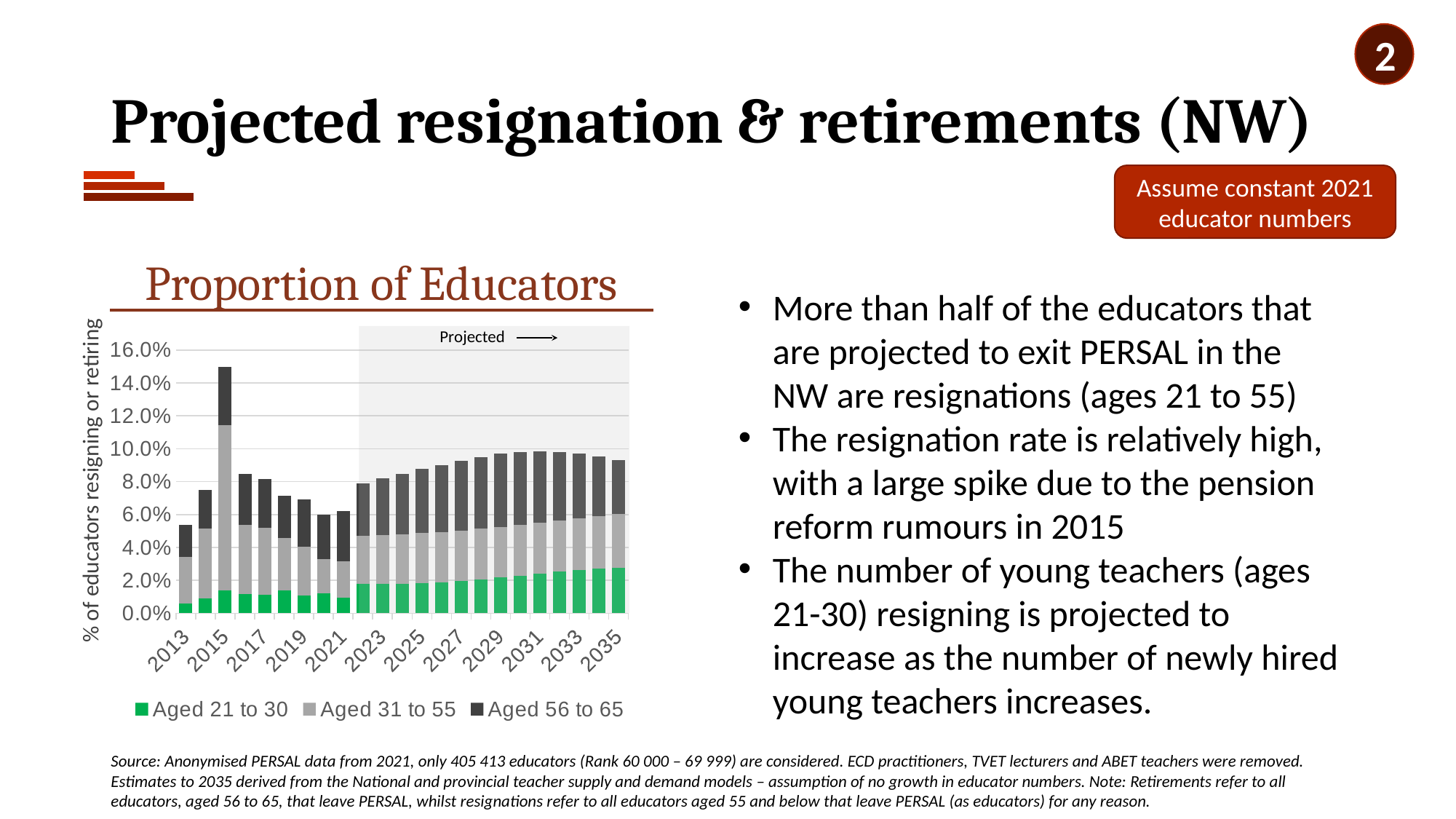
Is the total value for 2015 greater or less than 14.0%? greater What is the title of the chart? Proportion of Educators What kind of chart is shown on the slide? Stacked bar chart Do the total values rise or fall from 2022 to 2030 in the projected period? rise Which year has a larger total proportion, 2013 or 2014? 2014 Which year has the highest total proportion of educators resigning or retiring? 2015 How many years (bars) are plotted on the chart, from 2013 to 2035? 23 Which year has the lowest total proportion of educators resigning or retiring? 2013 How many series does the chart legend list? 3 Is the total value for 2021 greater or less than 8.0%? less Is the total value for 2031 greater or less than 8.0%? greater What are the three series listed in the chart legend? Aged 21 to 30, Aged 31 to 55, Aged 56 to 65